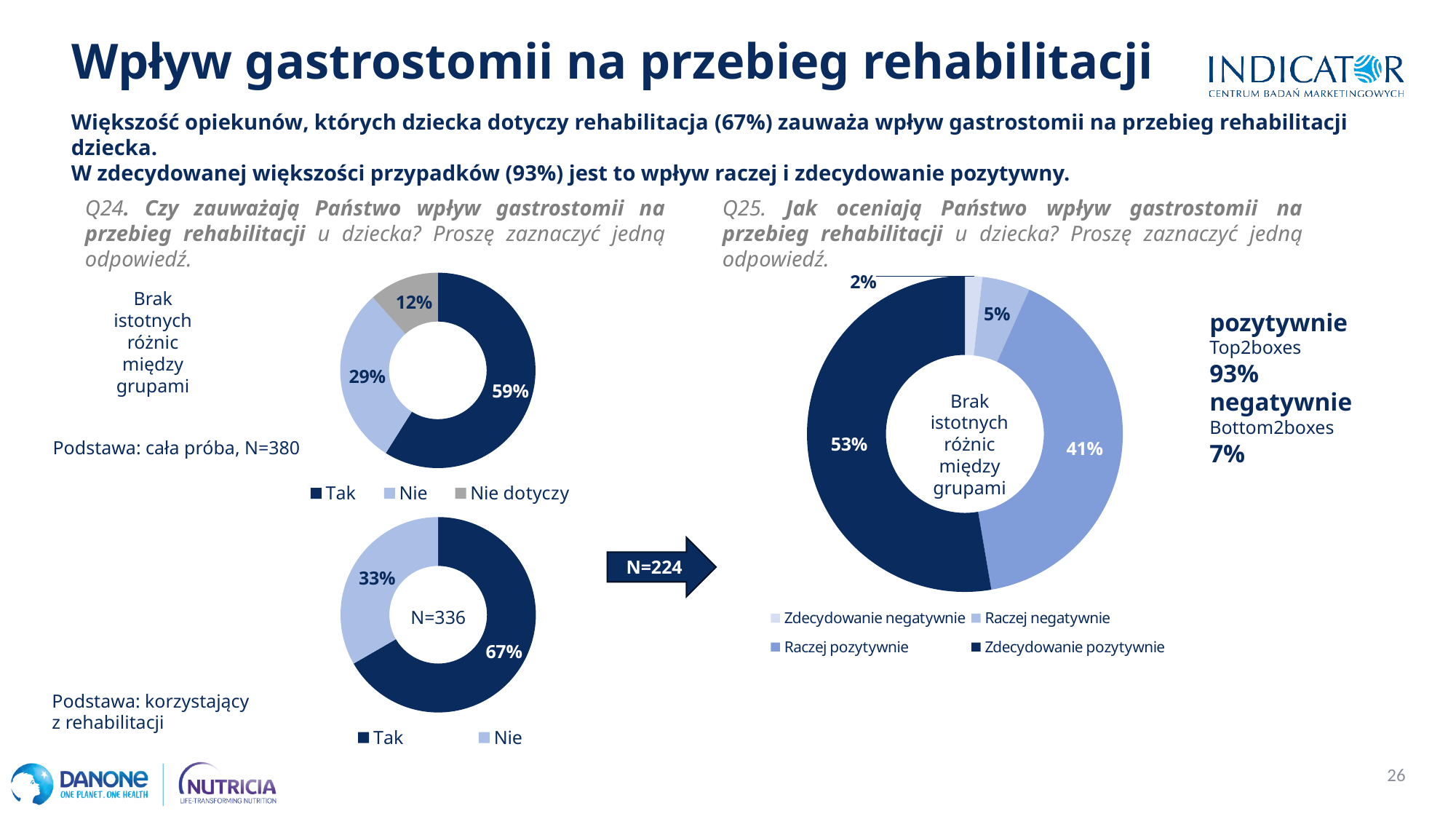
What type of chart is used on the right side of the slide for Q25? Donut (pie) chart In the bottom-left donut chart (Q24, N=336), which is larger, "Tak" or "Nie"? Tak In the top-left donut chart (Q24, whole sample N=380), what is the difference between the "Tak" and "Nie" shares? 29 percentage points In the right-hand donut chart (Q25), what is the combined share of "Raczej pozytywnie" and "Zdecydowanie pozytywnie"? 93% In the top-left donut chart (Q24, whole sample N=380), what percentage is shown for "Nie dotyczy"? 12% In the top-left donut chart (Q24, whole sample N=380), which category has the smallest share? Nie dotyczy In the bottom-left donut chart (Q24, N=336), what percentage is shown for "Nie"? 33% In the top-left donut chart (Q24, whole sample N=380), what percentage is shown for "Tak"? 59% In the right-hand donut chart (Q25), what percentage is shown for "Zdecydowanie pozytywnie"? 53% In the right-hand donut chart (Q25), which category has the smallest share? Zdecydowanie negatywnie In the right-hand donut chart (Q25), what percentage is shown for "Raczej negatywnie"? 5% How many categories does the legend of the top-left donut chart (Q24, whole sample) list? 3